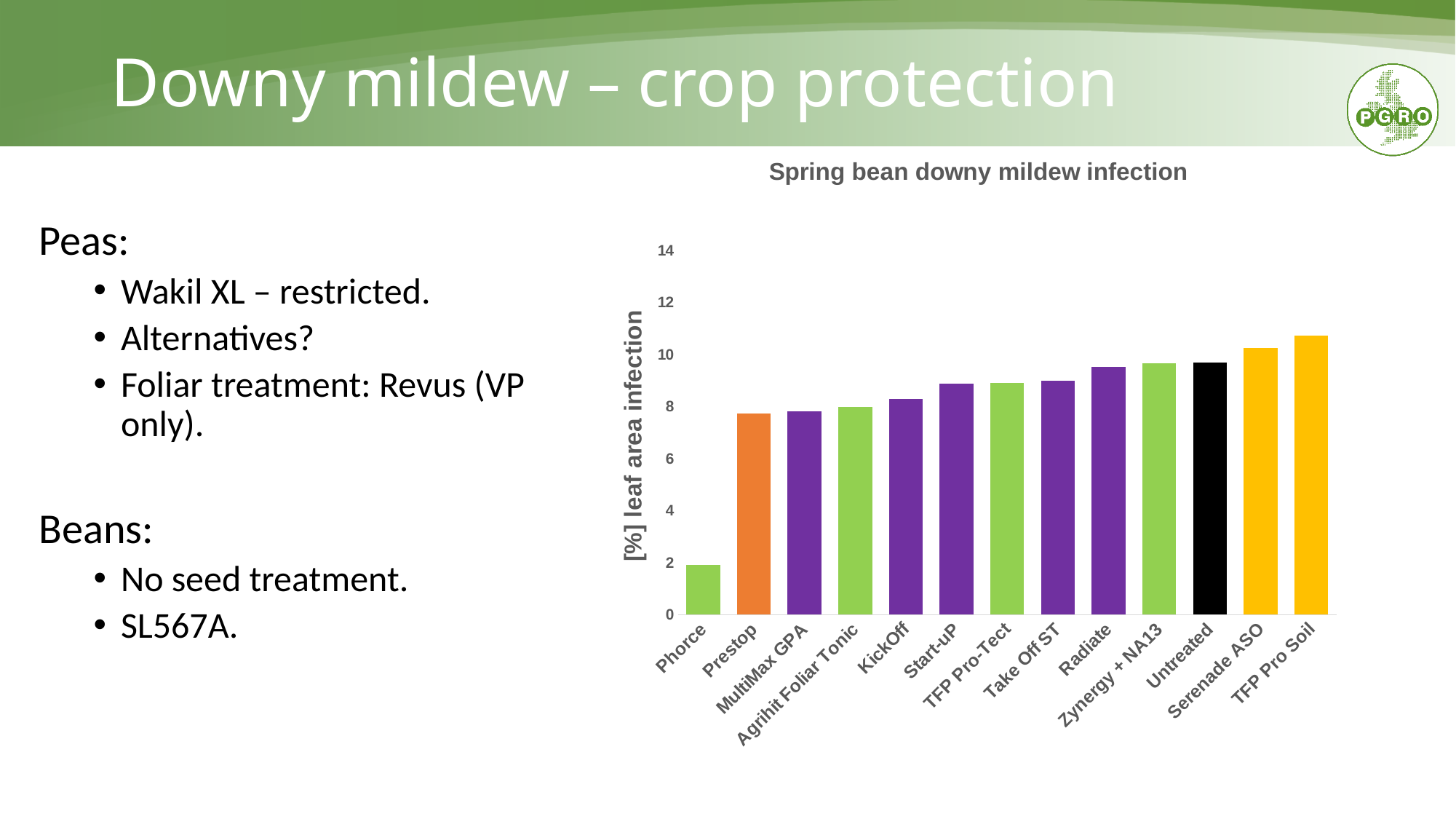
Which treatment has the lowest leaf area infection? Phorce How many treatments (bars) are shown in the chart? 13 What is the title of the chart? Spring bean downy mildew infection Is the value for TFP Pro Soil greater or less than 10? greater Is the value for Phorce greater or less than 4? less Which has a higher leaf area infection, Phorce or Prestop? Prestop Which treatment has the highest leaf area infection? TFP Pro Soil What kind of chart is shown on the slide? Bar chart What is the label on the vertical axis of the chart? [%] leaf area infection Is the value for KickOff greater or less than 10? less Which has a higher leaf area infection, Untreated or TFP Pro Soil? TFP Pro Soil